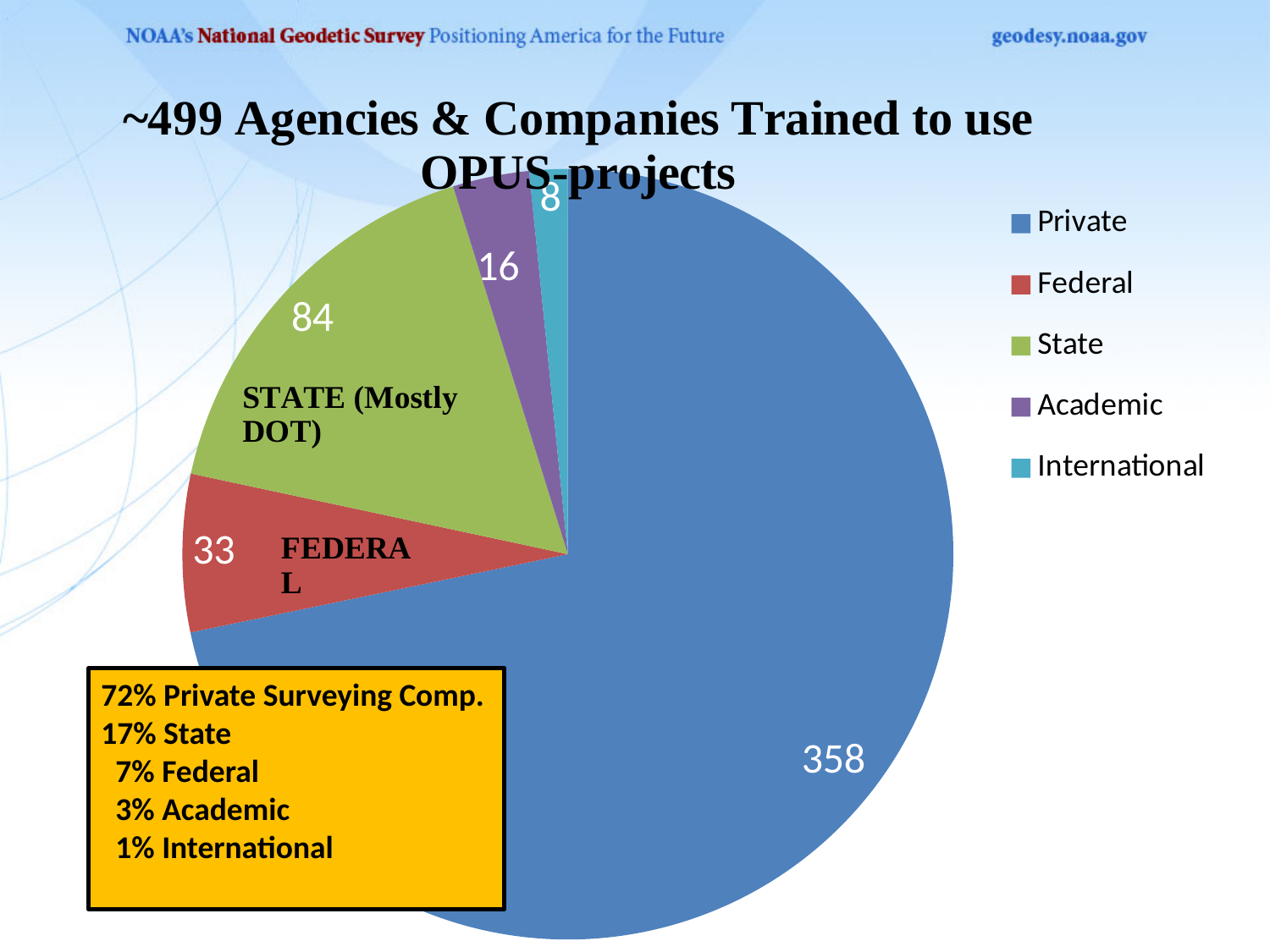
How many categories does the legend of the pie chart list? 5 Which category has the largest slice of the pie chart? Private What is the difference between the State value and the Federal value? 51 What is the value for Private in the pie chart? 358 What share of the pie does the Private slice represent, according to the slide? 72% What is the value for Academic in the pie chart? 16 Which category has the smallest slice of the pie chart? International What is the value for International in the pie chart? 8 Which is larger, the Academic value or the Federal value? Federal What is the value for Federal in the pie chart? 33 What is the value for State in the pie chart? 84 What kind of chart is shown on the slide? pie chart